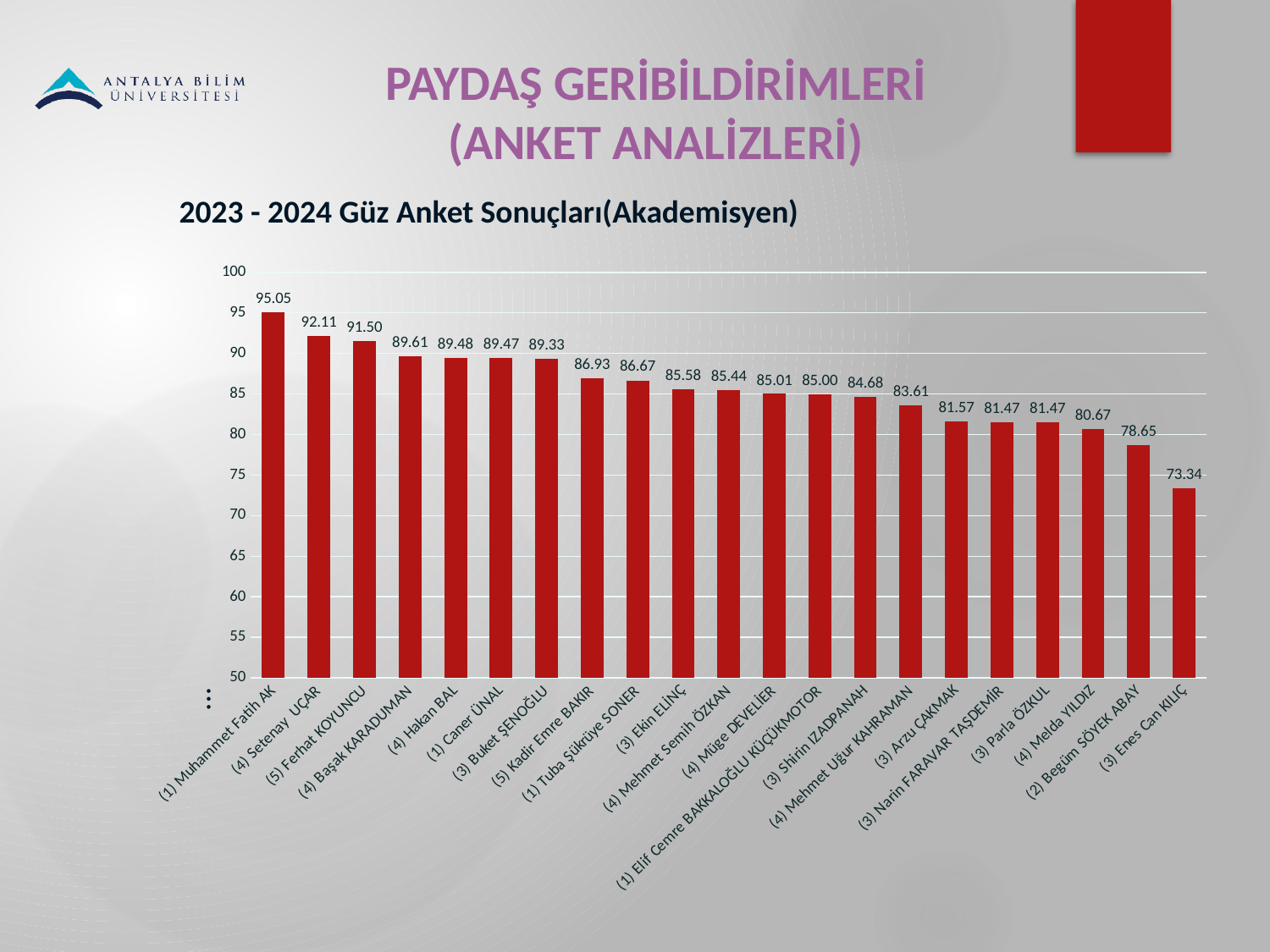
What is the difference between the highest and lowest values shown? 21.71 Which category has the lowest value? (3) Enes Can KILIÇ How many bars are shown in the chart? 21 What is the value for (2) Begüm SÖYEK ABAY? 78.65 Is the value for (4) Melda YILDIZ greater or less than 85? less What is the difference between the values for (4) Setenay UÇAR and (5) Ferhat KOYUNCU? 0.61 What is the value for (3) Buket ŞENOĞLU? 89.33 Which is larger, the value for (5) Kadir Emre BAKIR or the value for (3) Arzu ÇAKMAK? (5) Kadir Emre BAKIR What is the value for (1) Muhammet Fatih AK? 95.05 What kind of chart is shown on the slide? bar chart Which category has the highest value? (1) Muhammet Fatih AK Do the values rise or fall from left to right along the x axis? fall